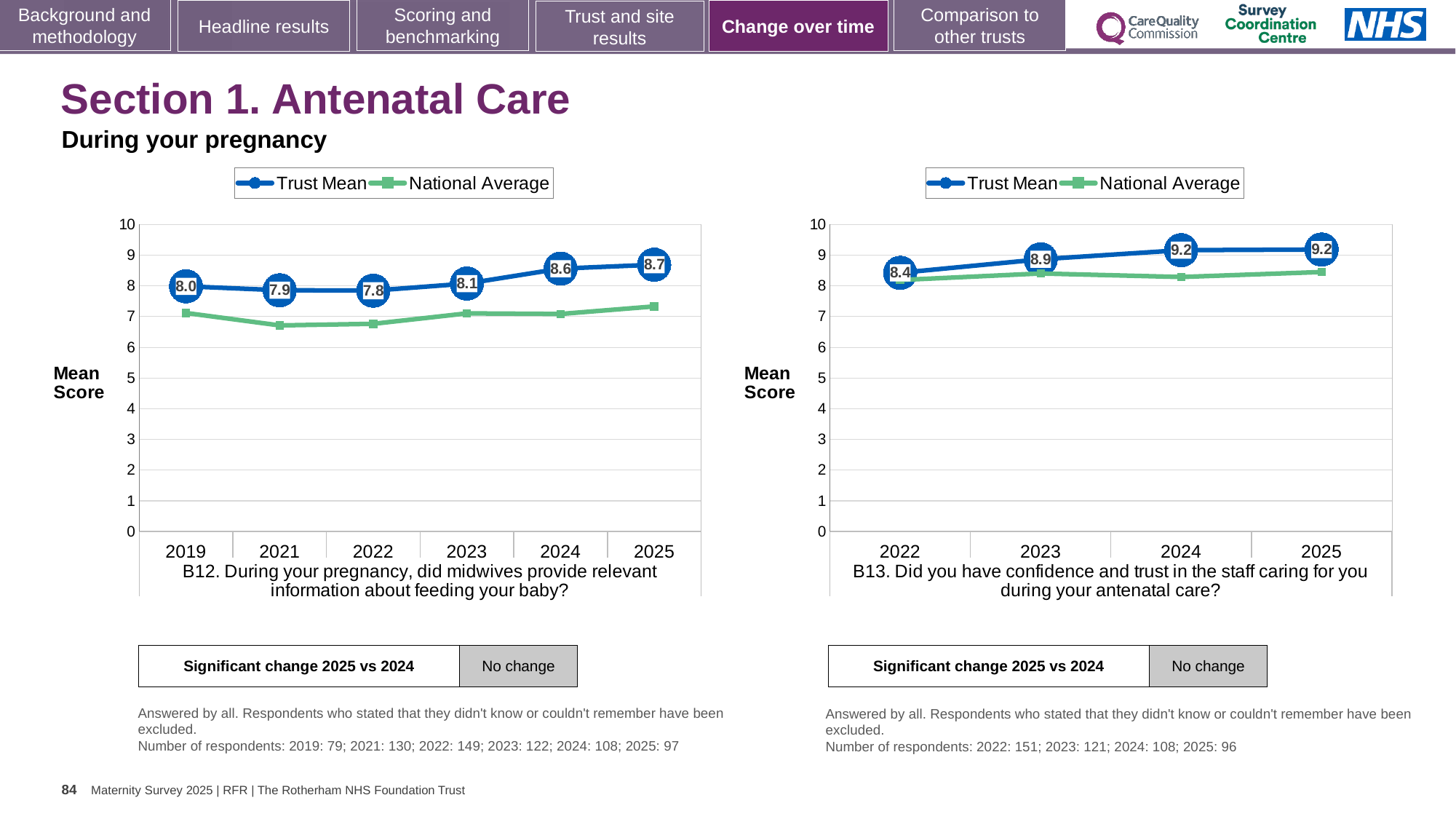
On the B12 chart (left), how many years are shown on the x axis? 6 On the B12 chart (left), which year has the highest Trust Mean score? 2025 On the B12 chart (left), what is the Trust Mean score for 2025? 8.7 On the B12 chart (left), which year has the lowest Trust Mean score? 2022 What kind of chart is the B13 chart (right)? line chart On the B13 chart (right), how many series does the legend list? 2 On the B13 chart (right), does the Trust Mean rise or fall from 2022 to 2025? rise On the B12 chart (left), is the National Average for 2021 greater or less than 7? less On the B12 chart (left), what is the difference between the Trust Mean scores for 2025 and 2019? 0.7 On the B13 chart (right), what is the Trust Mean score for 2022? 8.4 On the B12 chart (left), what is the Trust Mean score for 2022? 7.8 On the B13 chart (right), what is the difference between the Trust Mean scores for 2023 and 2022? 0.5